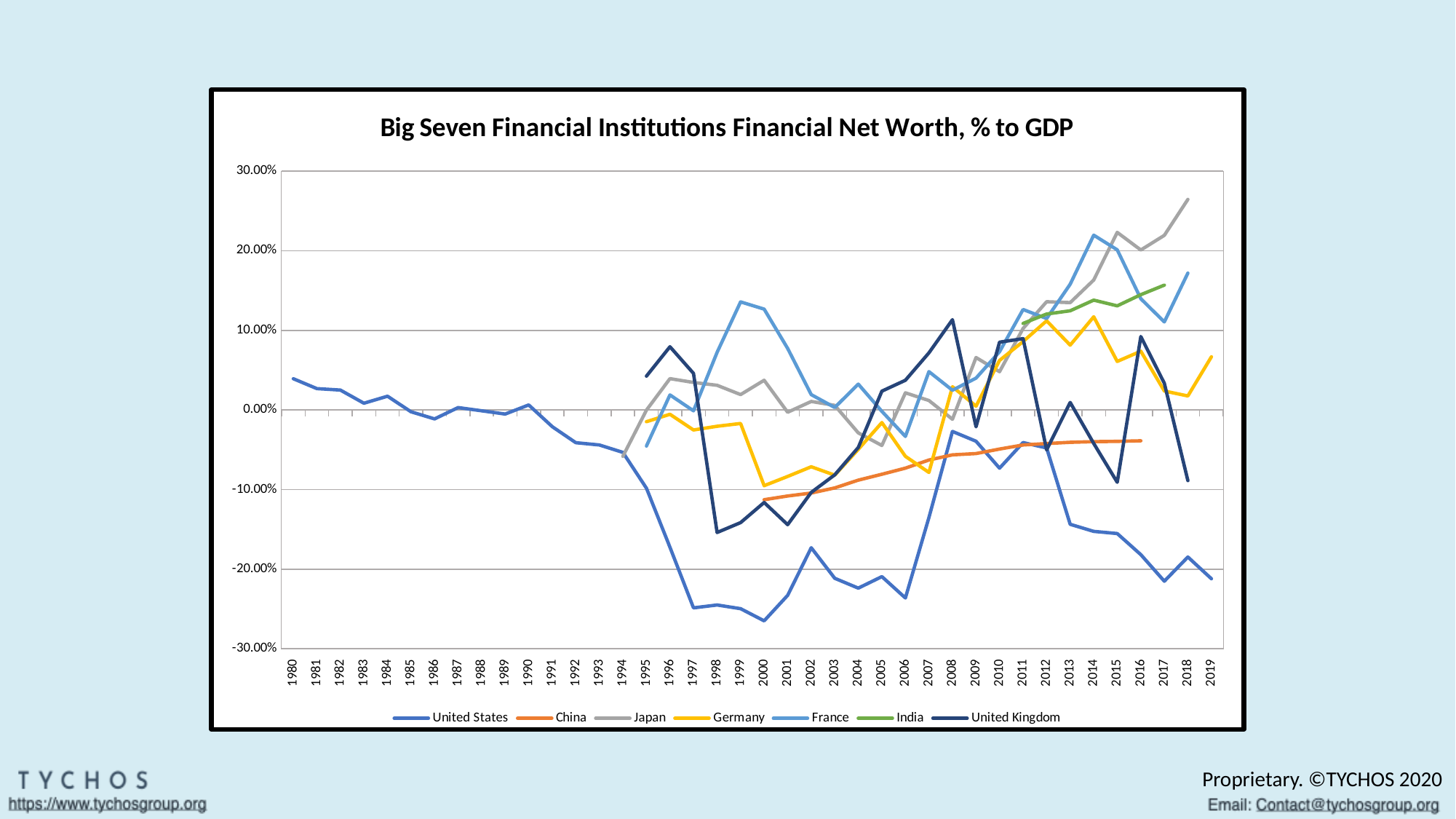
Does the United States line rise or fall from 1980 to 2000? fall Is the value for the United States in 2000 greater or less than -20.00%? less Is the value for the United Kingdom in 1998 greater or less than -10.00%? less Is the value for France in 1999 greater or less than 10.00%? greater What kind of chart is shown on the slide? line chart How many years are shown on the x axis? 40 How many series does the legend list? 7 Which series has the lowest value in 2019? United States What is the title of the chart? Big Seven Financial Institutions Financial Net Worth, % to GDP Which series has the highest value in 2019? Germany